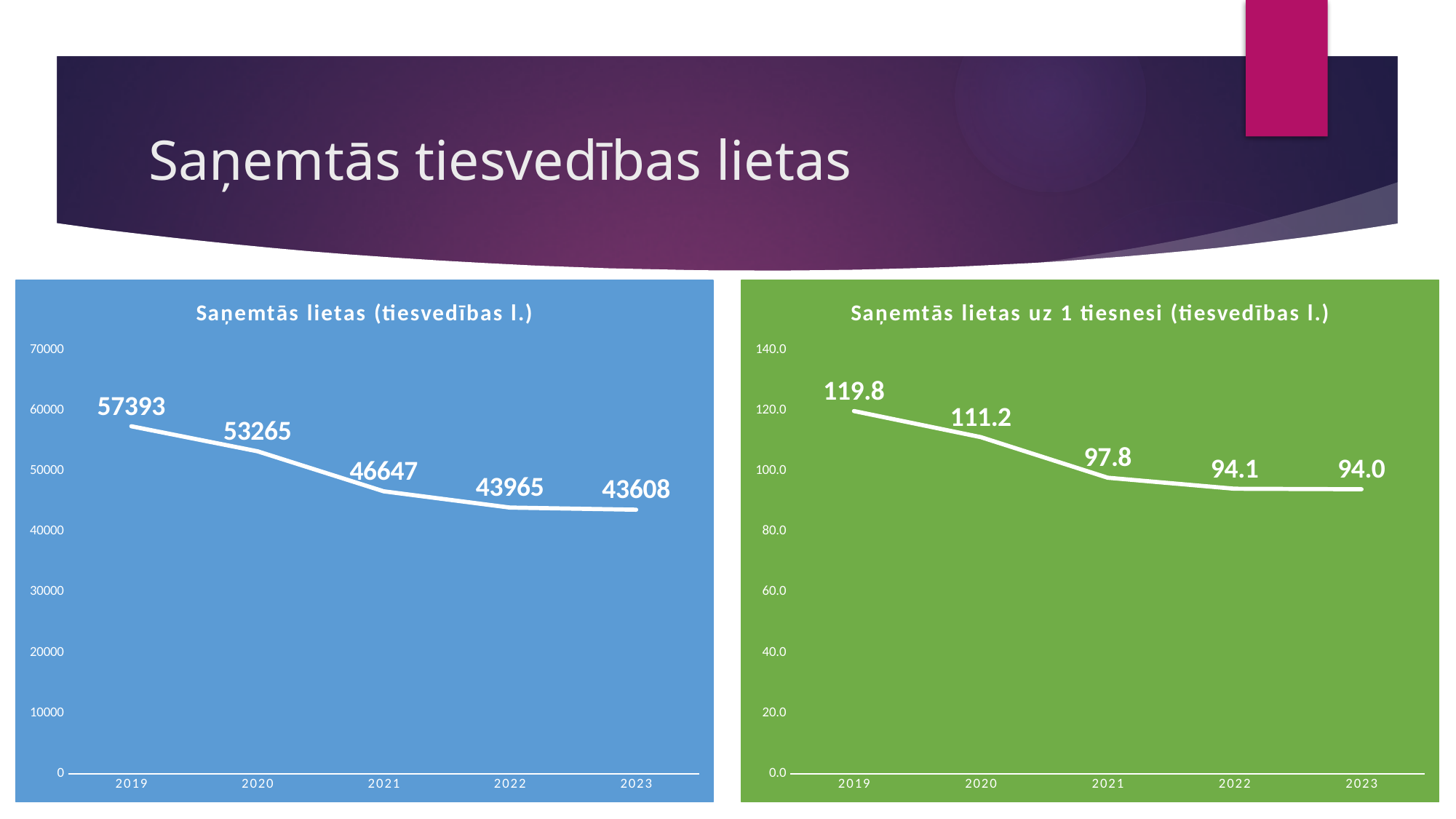
In the chart 'Saņemtās lietas uz 1 tiesnesi (tiesvedības l.)', what is the value for 2021? 97.8 What kind of chart is the chart on the left of the slide? line chart In the chart 'Saņemtās lietas (tiesvedības l.)', how many years are plotted? 5 In the chart 'Saņemtās lietas (tiesvedības l.)', what is the difference between the 2019 and 2020 values? 4128 In the chart 'Saņemtās lietas (tiesvedības l.)', which year has the lowest value? 2023 In the chart 'Saņemtās lietas uz 1 tiesnesi (tiesvedības l.)', what is the difference between the 2019 and 2023 values? 25.8 In the chart 'Saņemtās lietas (tiesvedības l.)', what is the value for 2022? 43965 In the chart 'Saņemtās lietas uz 1 tiesnesi (tiesvedības l.)', which is larger, the value for 2020 or the value for 2021? 2020 In the chart 'Saņemtās lietas uz 1 tiesnesi (tiesvedības l.)', which year has the highest value? 2019 In the chart 'Saņemtās lietas (tiesvedības l.)', what is the value for 2019? 57393 In the chart 'Saņemtās lietas (tiesvedības l.)', do the values rise or fall from 2019 to 2023? fall In the chart 'Saņemtās lietas uz 1 tiesnesi (tiesvedības l.)', what is the value for 2023? 94.0